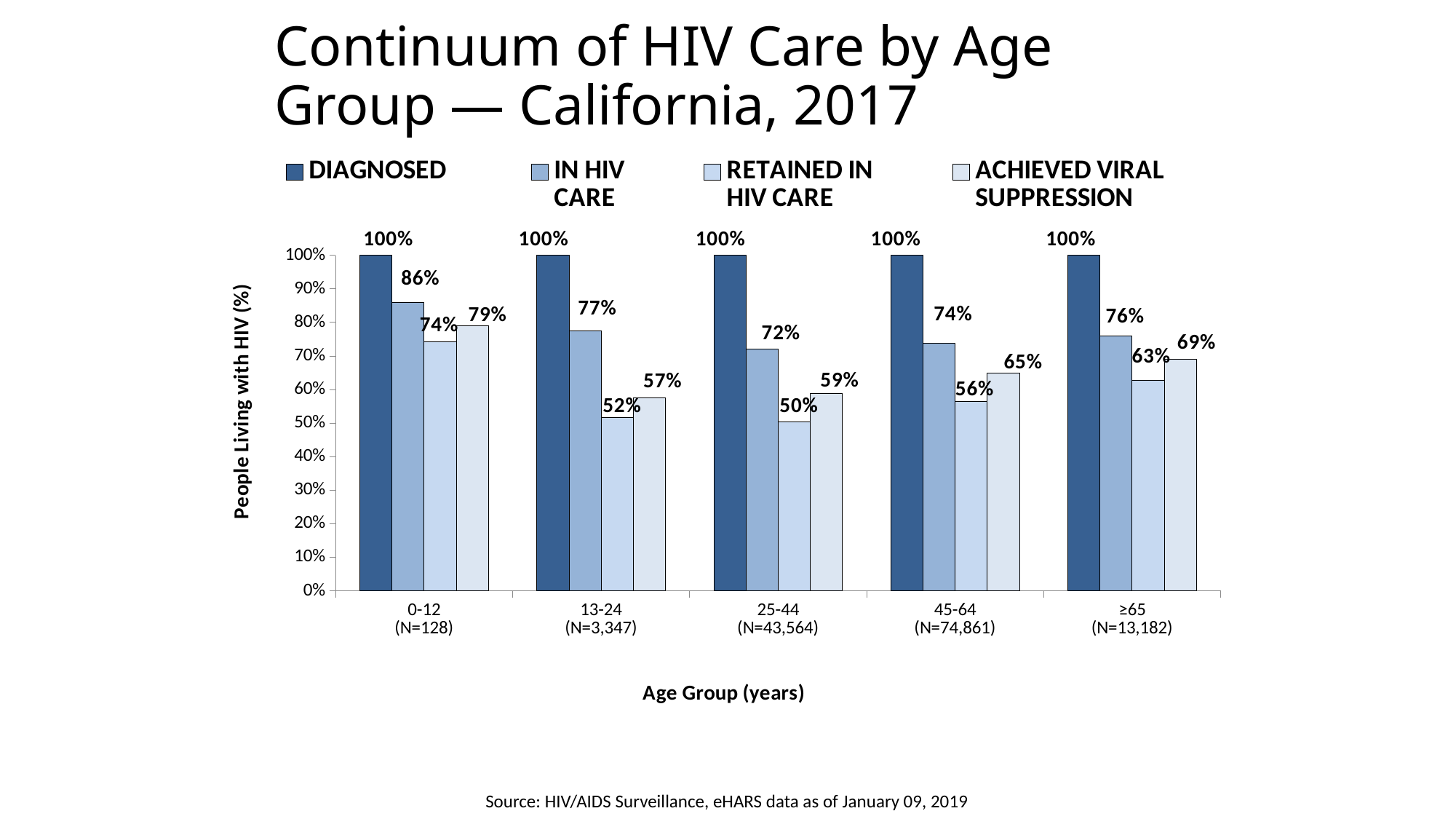
What is the N value shown for the 45-64 age group? 74,861 What is the label of the y axis? People Living with HIV (%) Which is larger: Achieved Viral Suppression for 45-64 or for 25-44? 45-64 What is the value for Retained in HIV Care in the 25-44 age group? 50% Which age group has the lowest value for Retained in HIV Care? 25-44 What percentage of the ≥65 age group achieved viral suppression? 69% What kind of chart is shown on the slide? Bar chart Which age group has the highest value for Achieved Viral Suppression? 0-12 How many series does the legend list? 4 How many age groups are shown on the x axis? 5 What percentage of people living with HIV aged 0-12 were in HIV care? 86% What is the difference between In HIV Care and Retained in HIV Care for the 13-24 age group? 25%